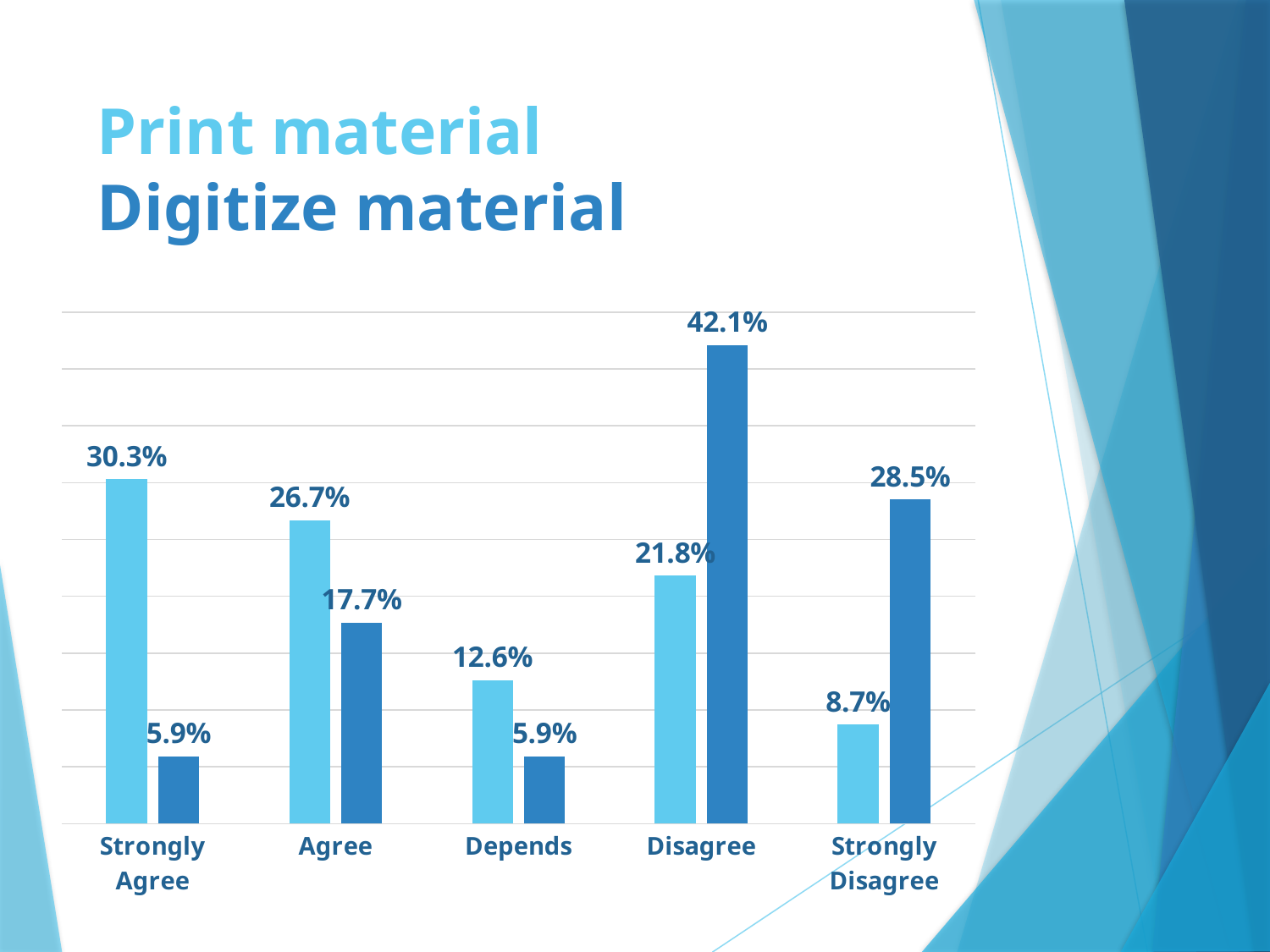
Which category has the lowest light blue bar? Strongly Disagree What is the difference between the light blue and dark blue bars for Strongly Agree? 24.4% What is the value of the dark blue bar for Agree? 17.7% How many categories are shown on the x axis? 5 For Depends, which bar is larger, the light blue or the dark blue? light blue What is the value of the dark blue bar for Disagree? 42.1% Which category has the highest light blue bar? Strongly Agree What is the value of the light blue bar for Strongly Agree? 30.3% Which category has the highest dark blue bar? Disagree What is the difference between the dark blue and light blue bars for Disagree? 20.3% What type of chart is shown on the slide? bar chart What is the value of the light blue bar for Strongly Disagree? 8.7%